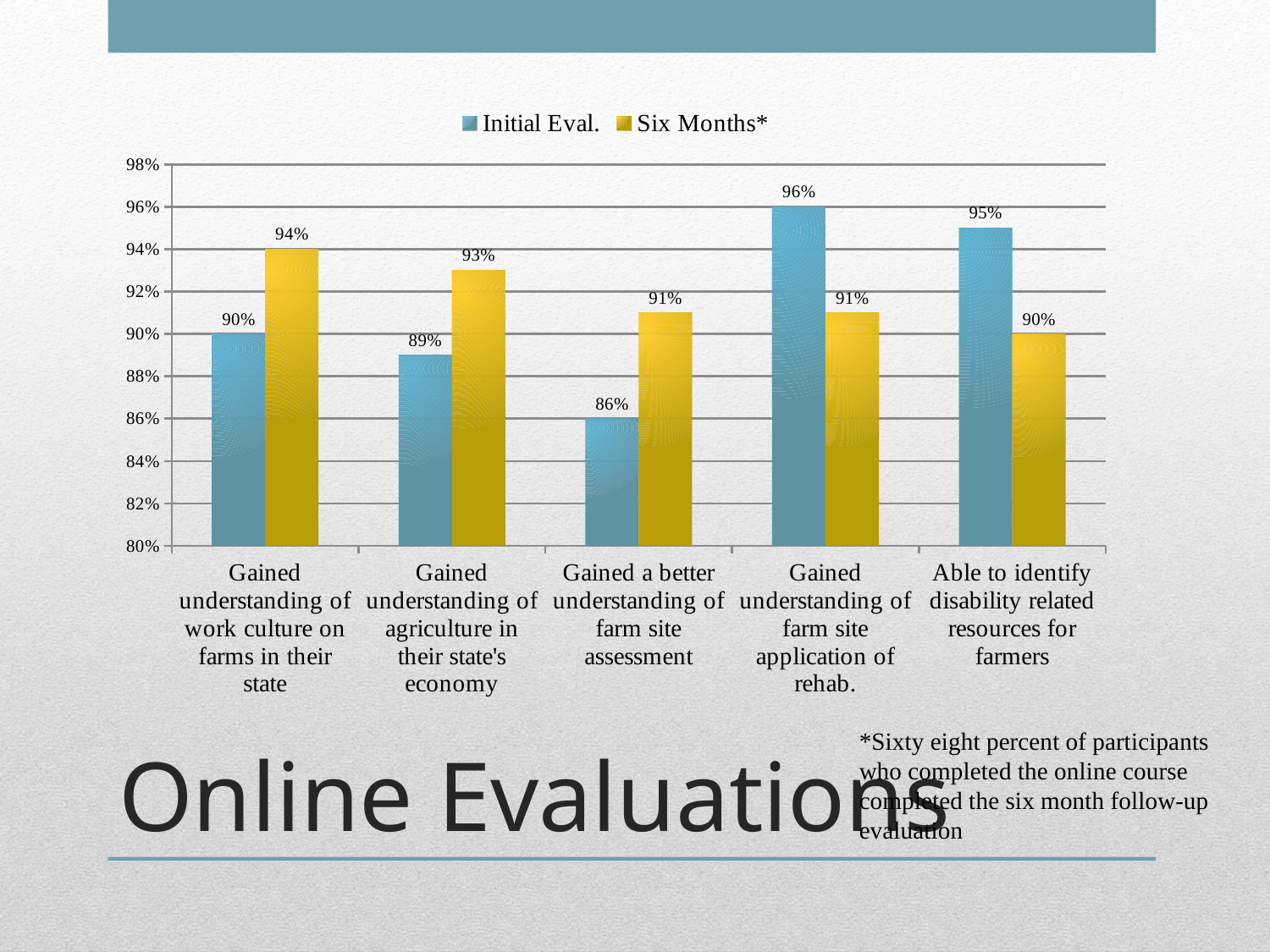
What is the Initial Eval. value for 'Able to identify disability related resources for farmers'? 95% For 'Gained understanding of farm site application of rehab.', which is larger: the Initial Eval. value or the Six Months* value? Initial Eval. What kind of chart is shown on the slide? Bar chart Which category has the highest Initial Eval. value? Gained understanding of farm site application of rehab. What is the Initial Eval. value for 'Gained a better understanding of farm site assessment'? 86% How many series does the legend list? 2 What is the Six Months* value for 'Gained understanding of agriculture in their state's economy'? 93% Which category has the highest Six Months* value? Gained understanding of work culture on farms in their state How many categories are shown on the x axis? 5 What is the difference between the Six Months* and Initial Eval. values for 'Gained a better understanding of farm site assessment'? 5% Which category has the lowest Initial Eval. value? Gained a better understanding of farm site assessment Which colour represents the Six Months* series? Yellow